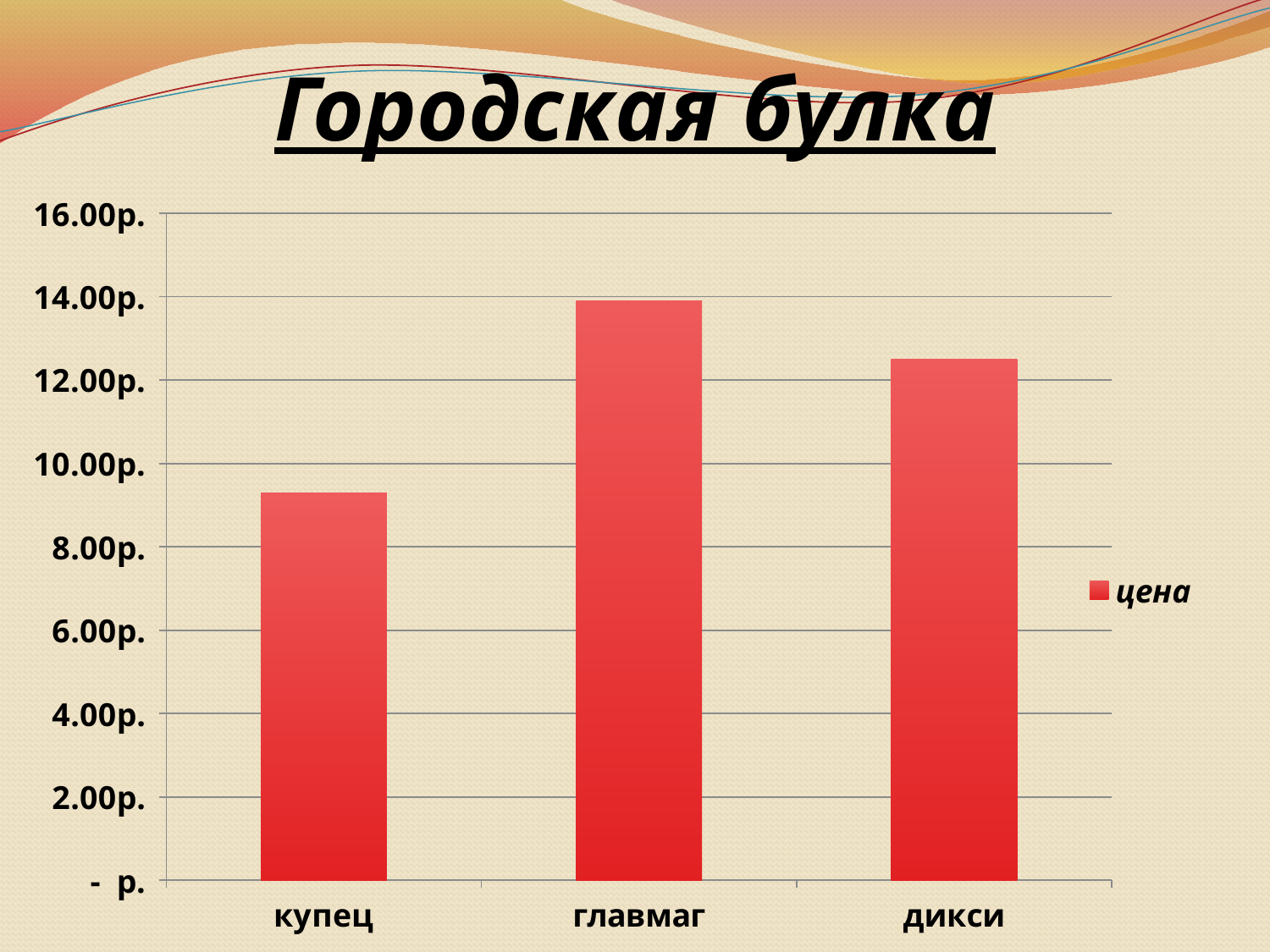
Is the value for главмаг greater or less than 12.00р.? greater How many series does the chart's legend list? 1 What kind of chart is shown on the slide? bar chart Is the value for дикси greater or less than 14.00р.? less Which has the larger value, главмаг or дикси? главмаг Is the value for купец greater or less than 10.00р.? less What is the name of the series shown in the chart's legend? цена What is the title of the chart on the slide? Городская булка Which has the larger value, купец or дикси? дикси Which category has the lowest value in the chart? купец Which category has the highest value in the chart? главмаг How many categories are shown on the x axis of the chart? 3